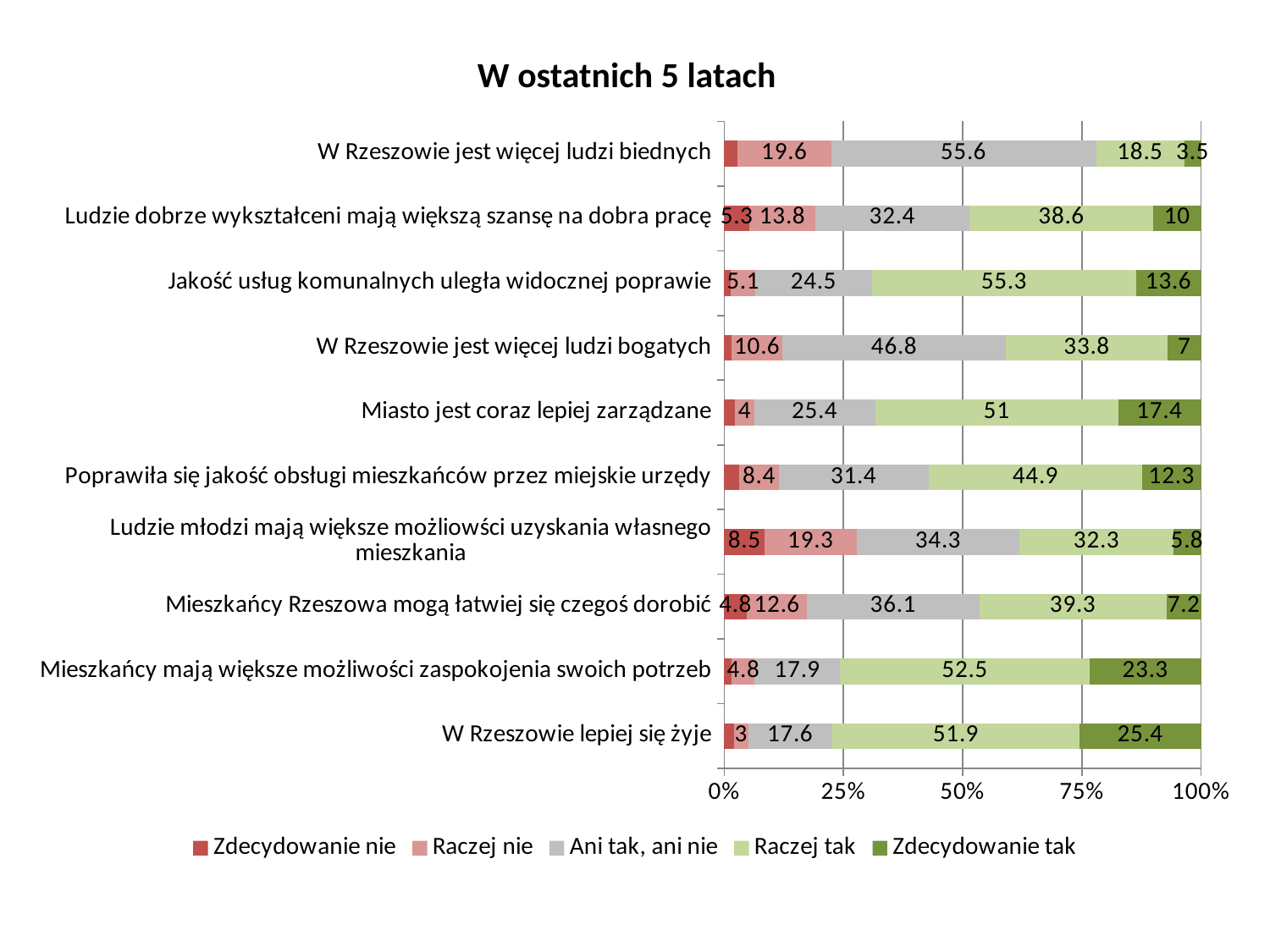
What type of chart is shown on the slide? Stacked bar chart How many statements (categories) are shown on the chart? 10 What is the 'Raczej tak' value for 'Jakość usług komunalnych uległa widocznej poprawie'? 55.3 What is the difference between the 'Raczej tak' values for 'Miasto jest coraz lepiej zarządzane' and 'W Rzeszowie jest więcej ludzi bogatych'? 17.2 Which statement has the highest 'Zdecydowanie tak' value? W Rzeszowie lepiej się żyje What is the 'Zdecydowanie tak' value for 'W Rzeszowie lepiej się żyje'? 25.4 What is the 'Ani tak, ani nie' value for 'W Rzeszowie jest więcej ludzi biednych'? 55.6 What is the 'Zdecydowanie nie' value for 'Ludzie młodzi mają większe możliowści uzyskania własnego mieszkania'? 8.5 What is the title of the chart? W ostatnich 5 latach How many series does the legend list? 5 Which statement has the lowest 'Zdecydowanie tak' value? W Rzeszowie jest więcej ludzi biednych Which is larger: the 'Raczej nie' value for 'Ludzie młodzi mają większe możliowści uzyskania własnego mieszkania' or for 'Mieszkańcy Rzeszowa mogą łatwiej się czegoś dorobić'? Ludzie młodzi mają większe możliowści uzyskania własnego mieszkania